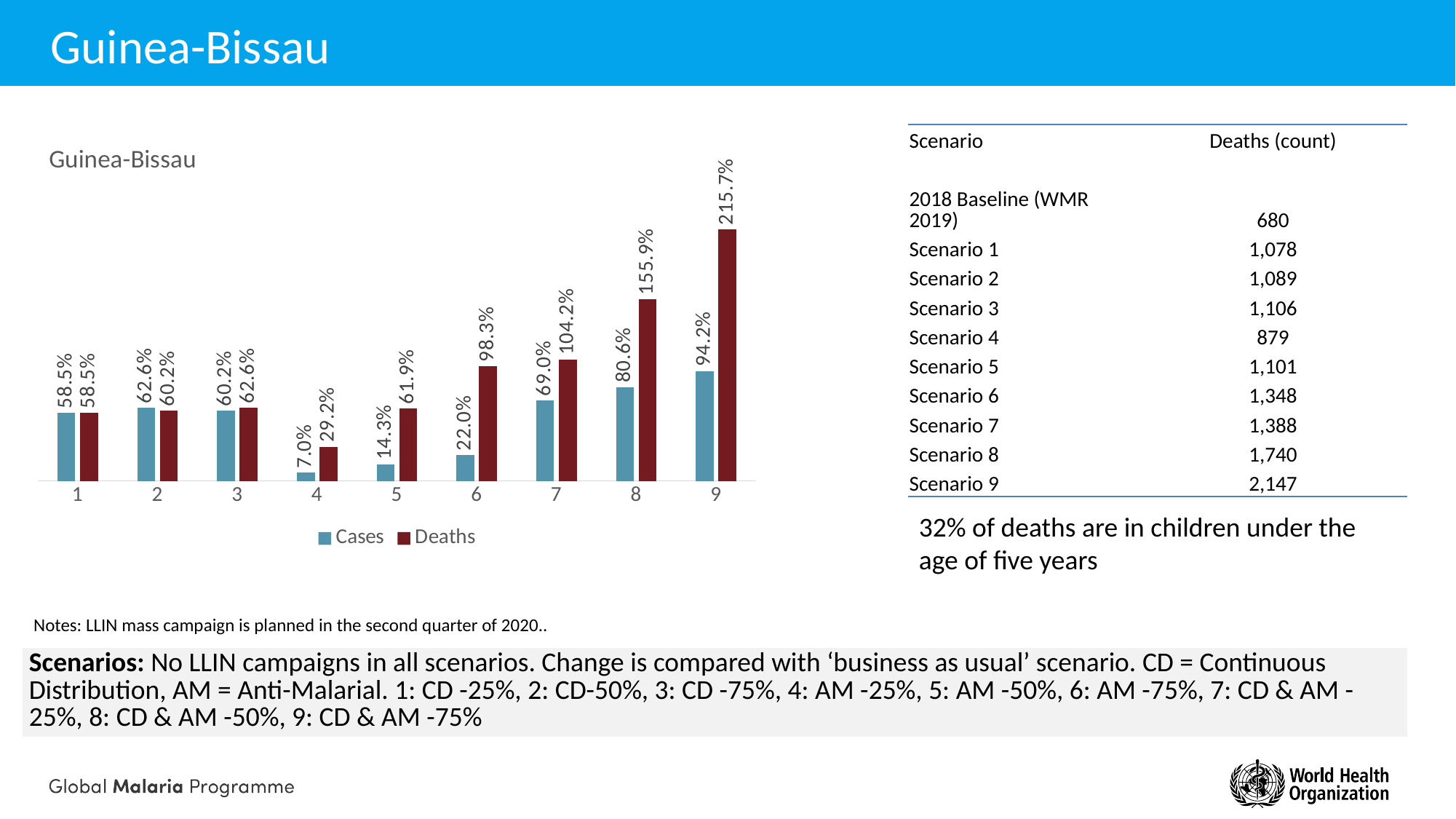
What is the Deaths value for scenario 6? 98.3% How many scenarios are shown on the x axis of the chart? 9 Which scenario has the lowest Cases value? 4 What kind of chart is shown on the slide? Bar chart How many series does the chart legend list? 2 What is the Deaths value for scenario 9? 215.7% What colour are the Deaths bars in the chart? Dark red What is the Cases value for scenario 4? 7.0% Which is larger for scenario 5: the Cases value or the Deaths value? Deaths Do the Deaths values rise or fall from scenario 6 to scenario 9? Rise What is the difference between the Deaths and Cases values for scenario 8? 75.3% Which scenario has the highest Deaths value? 9